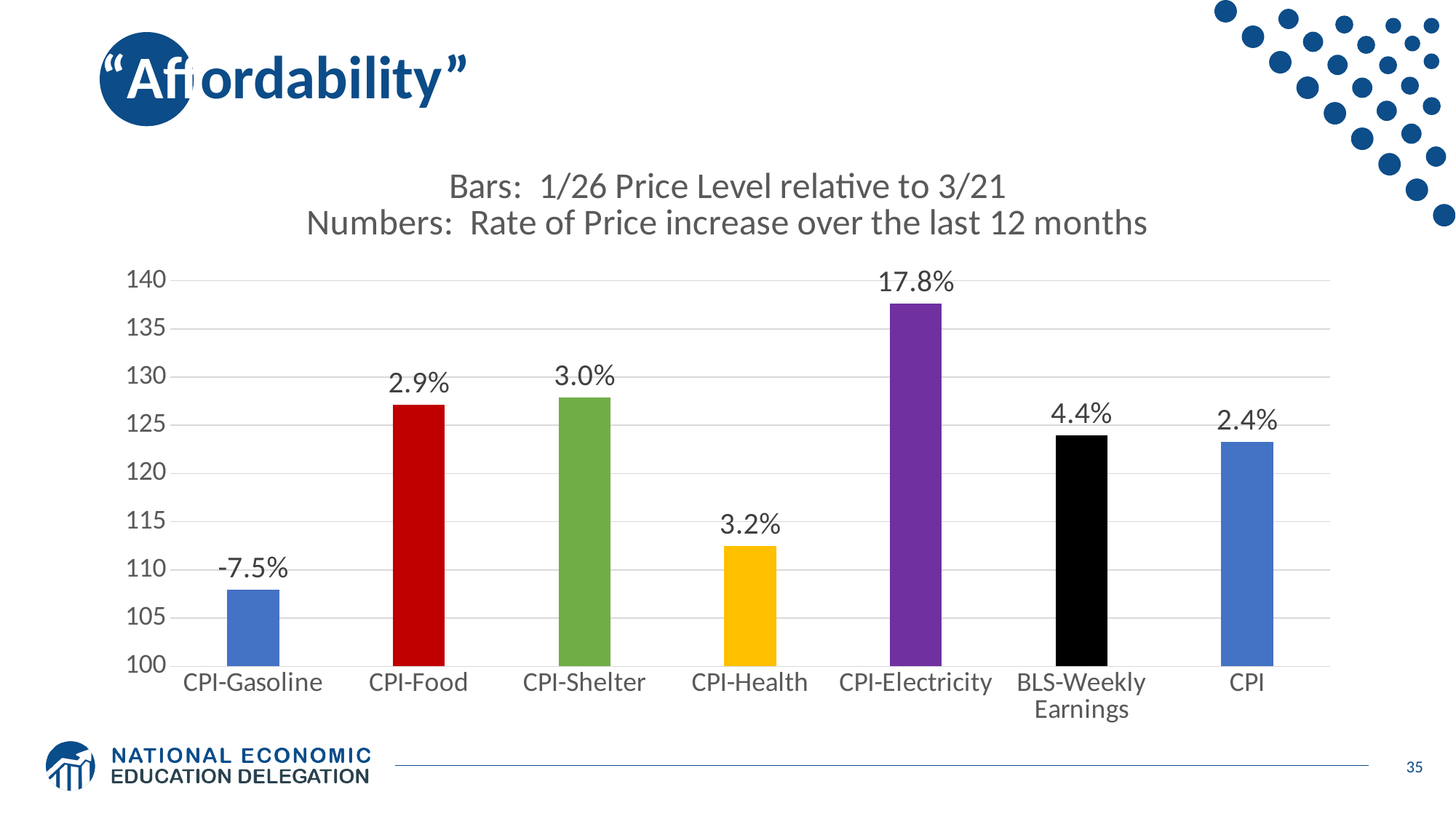
What is the 12-month rate of increase shown for CPI-Health? 3.2% Which category has the tallest bar (highest price level relative to 3/21)? CPI-Electricity Is the bar for CPI-Health greater or less than 115? less What is the 12-month rate of increase shown for BLS-Weekly Earnings? 4.4% Which has the higher printed 12-month rate of increase, CPI-Food or CPI-Shelter? CPI-Shelter What is the rate of price increase over the last 12 months shown for CPI-Electricity? 17.8% What is the rate of price increase over the last 12 months shown for CPI-Gasoline? -7.5% How many categories are shown on the x axis of the chart? 7 Is the bar for CPI-Electricity greater or less than 135? greater What is the difference in percentage points between the 12-month rate for CPI-Electricity and the rate for CPI? 15.4 percentage points Which category has the lowest 12-month rate of price increase printed on the chart? CPI-Gasoline Which category has the shortest bar (lowest price level relative to 3/21)? CPI-Gasoline